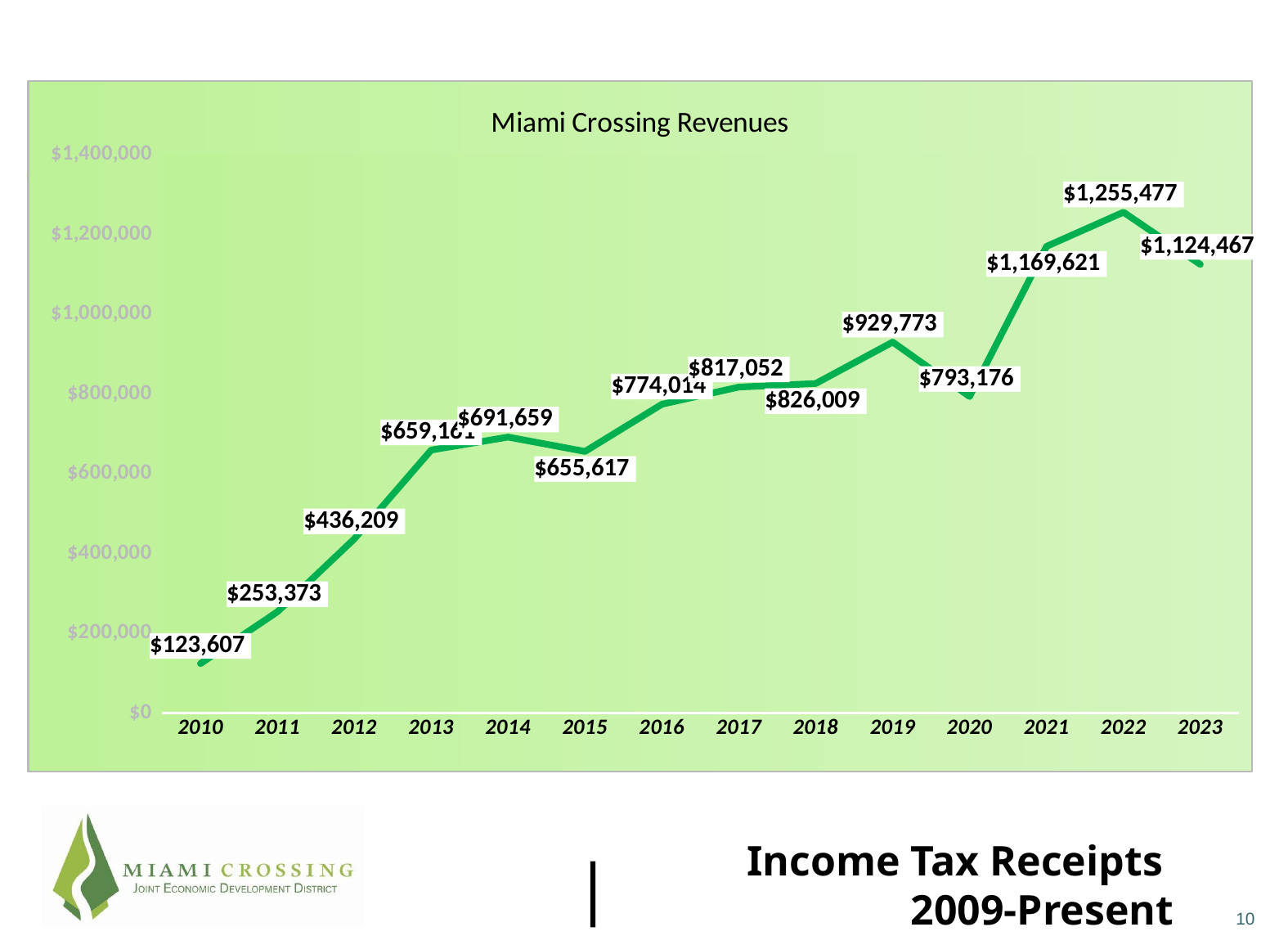
What is the difference between the 2019 and 2020 revenue values? $136,597 What type of chart is shown on the slide? Line chart Which year has the lowest revenue? 2010 What is the revenue value for 2020? $793,176 What is the revenue value for 2015? $655,617 Which is larger, the revenue for 2014 or for 2015? 2014 Which year has the highest revenue? 2022 How many years are plotted on the chart? 14 Is the value for 2019 greater or less than $800,000? greater What is the revenue value for 2010? $123,607 What is the difference between the 2022 and 2021 revenue values? $85,856 What is the revenue value for 2022? $1,255,477